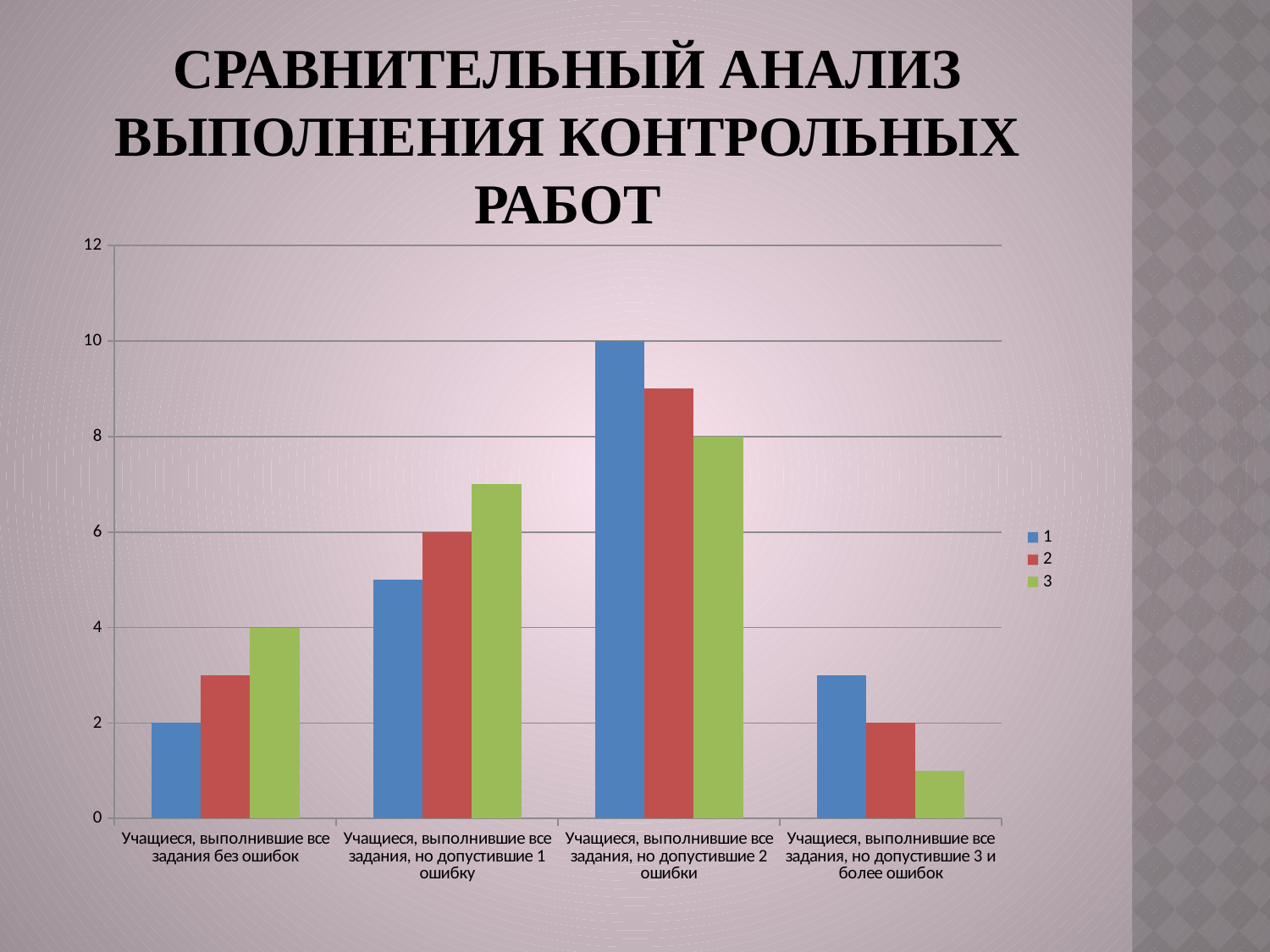
What is the value of series 3 for "Учащиеся, выполнившие все задания, но допустившие 2 ошибки"? 8 What is the value of series 2 for "Учащиеся, выполнившие все задания, но допустившие 1 ошибку"? 6 Is the value of series 2 for "Учащиеся, выполнившие все задания, но допустившие 2 ошибки" greater or less than 8? greater Which category has the lowest value for series 3? Учащиеся, выполнившие все задания, но допустившие 3 и более ошибок What is the value of series 1 for "Учащиеся, выполнившие все задания без ошибок"? 2 How many series does the legend list? 3 Which category has the highest value for series 1? Учащиеся, выполнившие все задания, но допустившие 2 ошибки For "Учащиеся, выполнившие все задания, но допустившие 1 ошибку", which is larger: series 1 or series 3? series 3 What is the value of series 3 for "Учащиеся, выполнившие все задания без ошибок"? 4 What kind of chart is shown on the slide? bar chart What is the value of series 1 for "Учащиеся, выполнившие все задания, но допустившие 2 ошибки"? 10 How many categories are shown on the x axis? 4